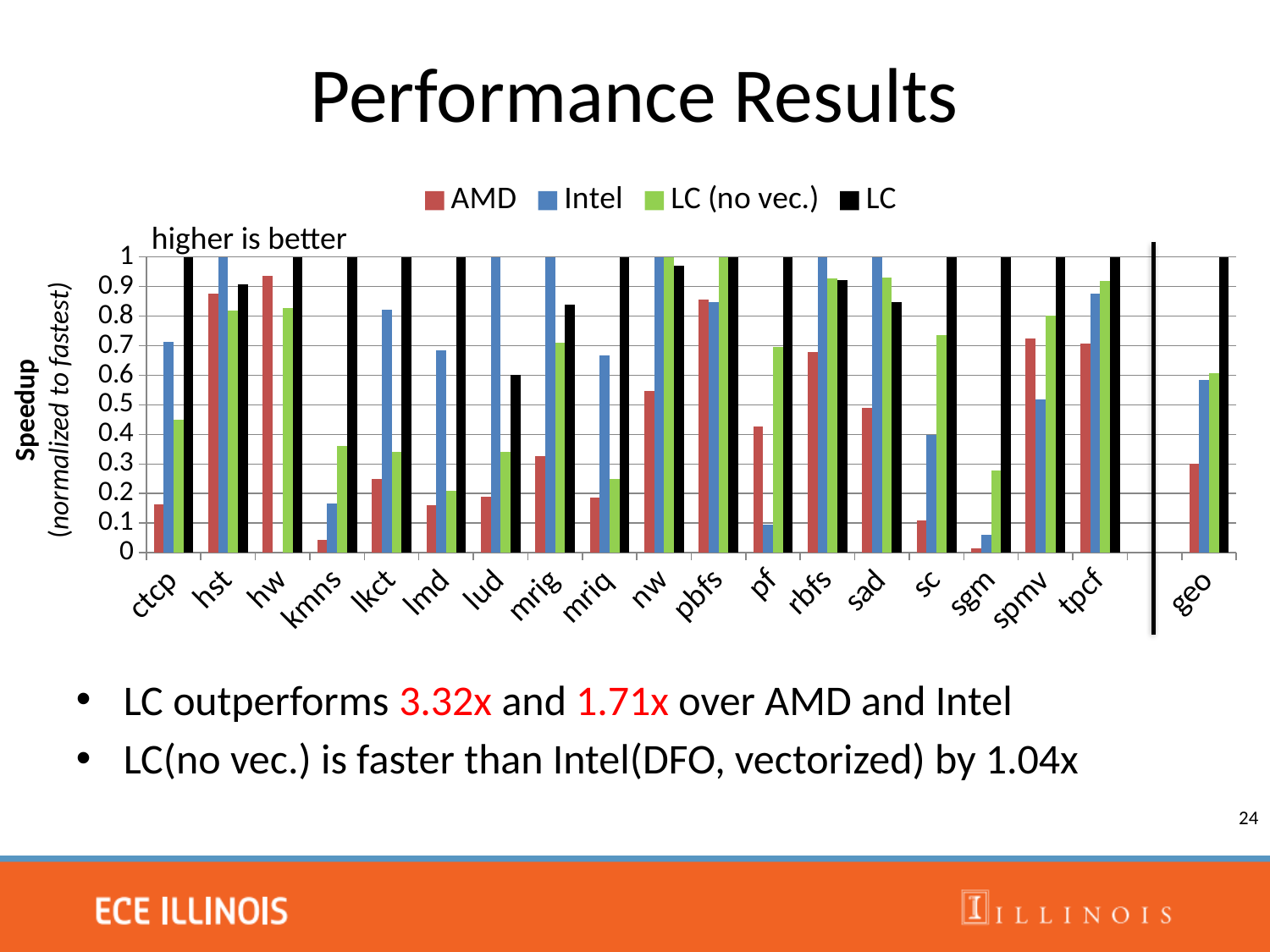
Is the value of the Intel series for lkct greater or less than 0.7? greater What is the value of the LC (no vec.) series for pbfs? 1 Is the value of the AMD series for ctcp greater or less than 0.2? less What is the value of the Intel series for hst? 1 Which series has the lowest value for sgm? AMD Is the value of the AMD series for geo greater or less than 0.4? less What kind of chart is shown on the slide? bar chart What is the label on the y axis? Speedup (normalized to fastest) For kmns, which is larger: the Intel value or the LC (no vec.) value? LC (no vec.) How many series does the legend list? 4 How many categories are shown along the x axis? 19 What is the value of the LC series for ctcp? 1